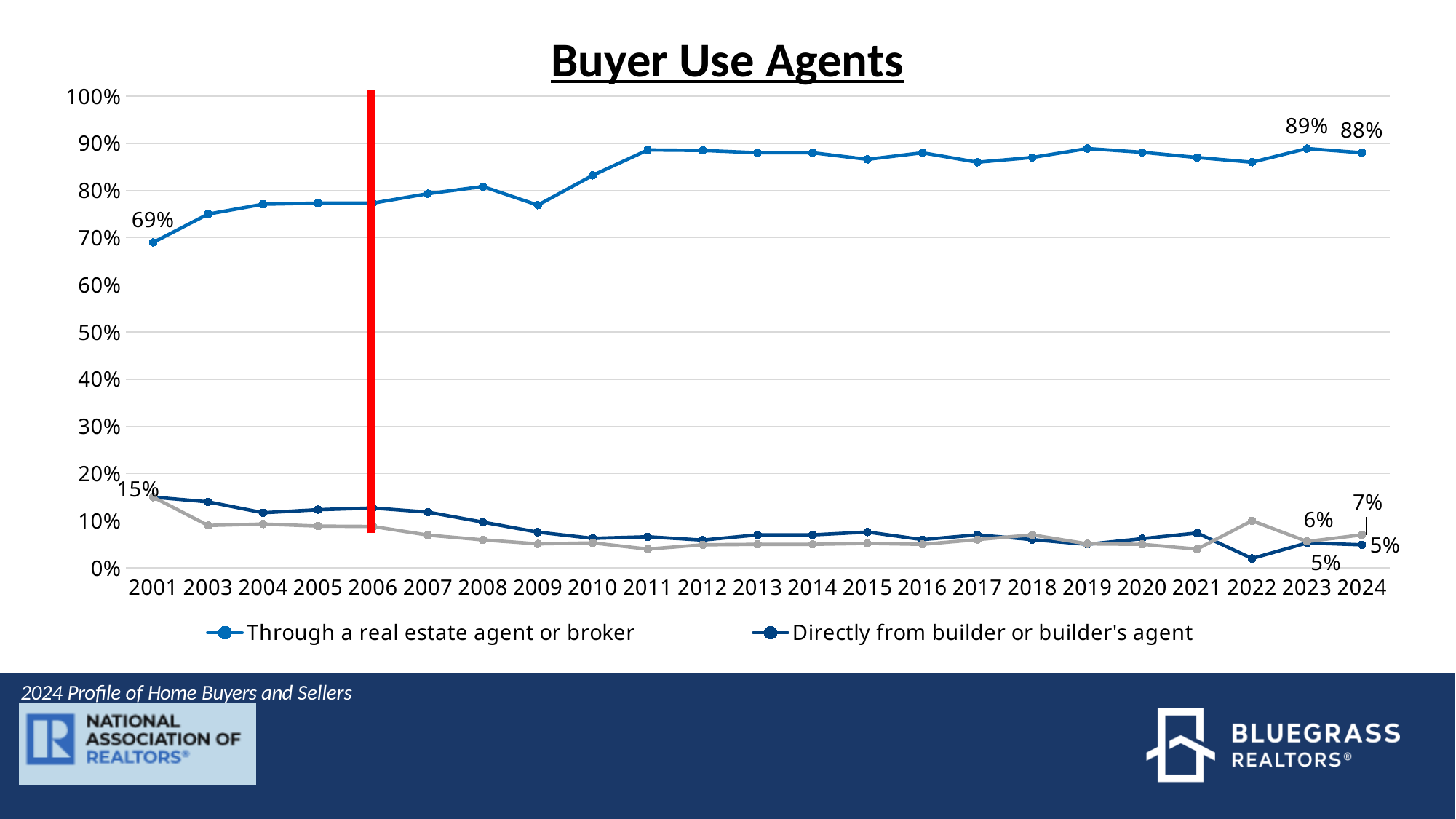
What percentage of buyers bought through a real estate agent or broker in 2024? 88% In 2001, which was larger: the share buying through a real estate agent or broker, or the share buying directly from a builder or builder's agent? Through a real estate agent or broker How many series does the legend list? 2 What kind of chart is shown on the slide? line chart What percentage of buyers bought through a real estate agent or broker in 2023? 89% What percentage of buyers bought directly from a builder or builder's agent in 2024? 5% What percentage of buyers bought through a real estate agent or broker in 2001? 69% What percentage of buyers bought directly from a builder or builder's agent in 2001? 15% What is the title of the chart? Buyer Use Agents How many years are shown on the x axis? 23 Is the value for 'Through a real estate agent or broker' in 2011 greater or less than 80%? greater By how many percentage points did the share buying through a real estate agent or broker change from 2001 to 2024? 19 percentage points